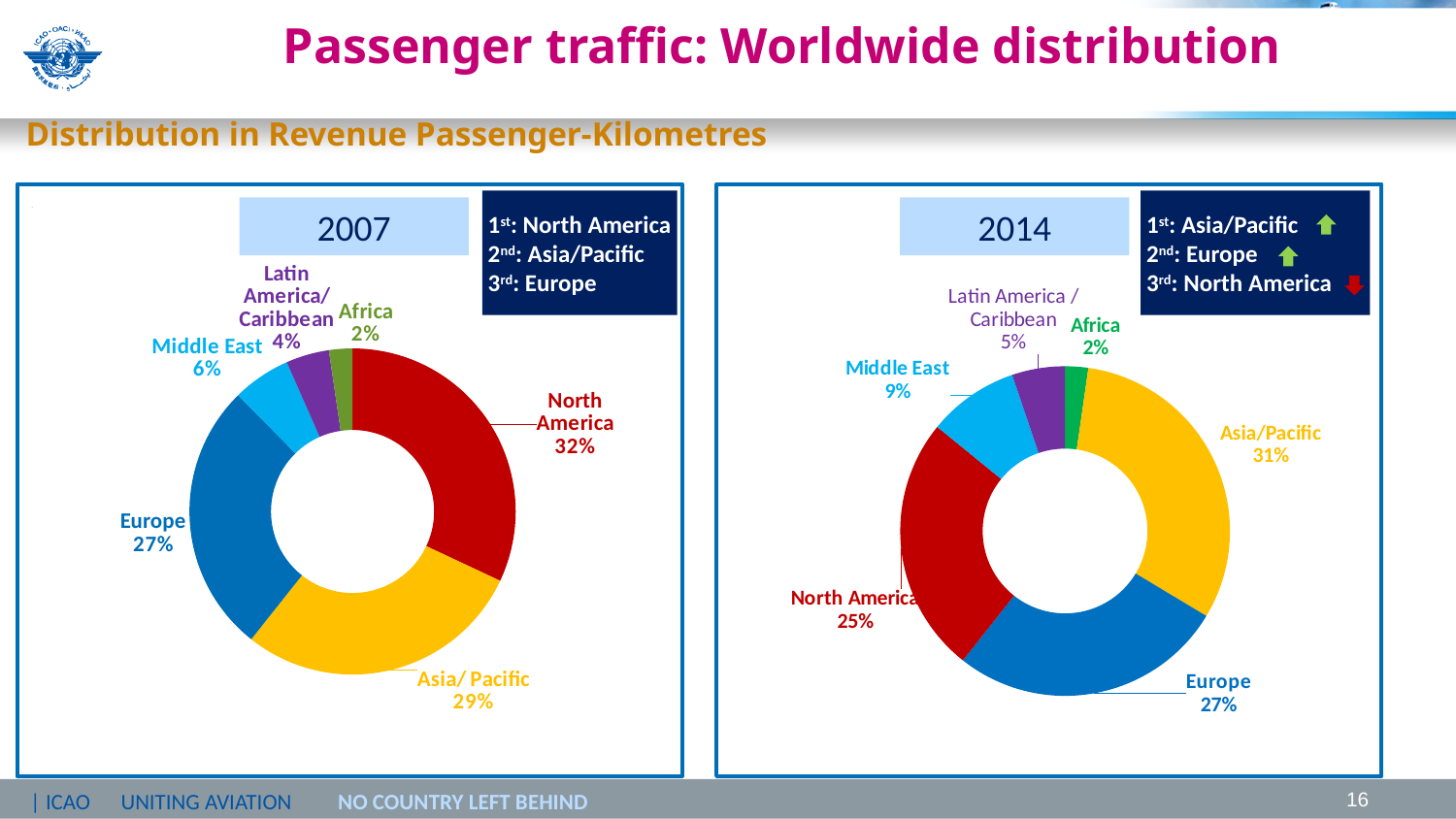
In the 2007 chart, which region has the largest share? North America How many regions are shown in the 2014 chart? 6 According to the ranking box on the 2014 chart, which region is ranked 1st? Asia/Pacific In the 2007 chart, which is larger, the share for Europe or the share for Asia/Pacific? Asia/Pacific In the 2014 chart, what share does Asia/Pacific have? 31% In the 2014 chart, what is the value for the Middle East? 9% In the 2014 chart, what is the difference between the Asia/Pacific share and the North America share? 6% In the 2014 chart, what is the combined share of Europe and North America? 52% In the 2007 chart, what share of revenue passenger-kilometres does North America have? 32% What kind of chart is used for the 2007 distribution? Pie (donut) chart In the 2007 chart, what is the difference between the Middle East share and the Latin America/Caribbean share? 2% In the 2014 chart, which region has the smallest share? Africa